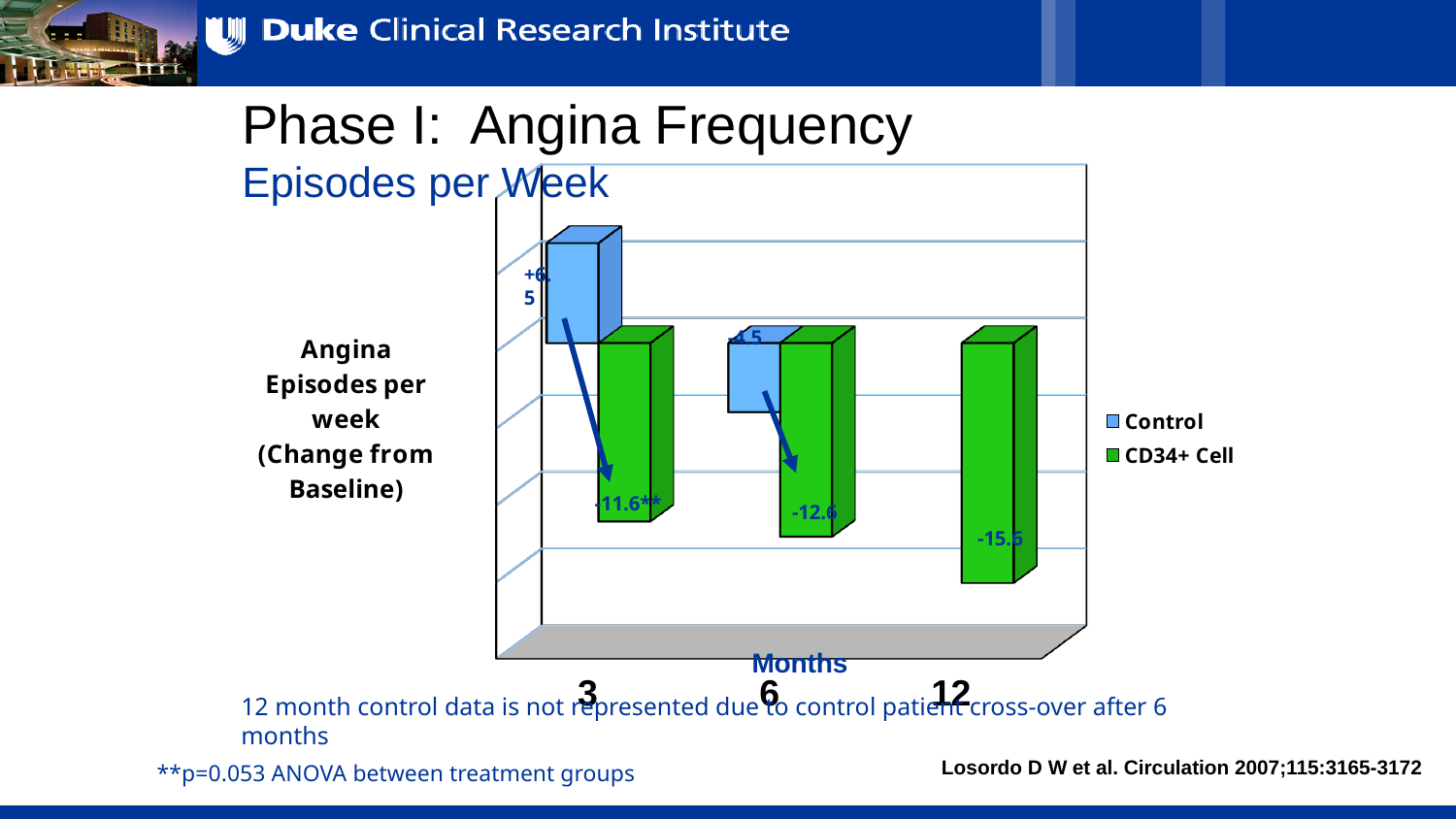
At 3 months, which series has the higher value, Control or CD34+ Cell? Control What is the value for the Control series at 3 months? +6.5 What is the difference between the CD34+ Cell values at 3 months and 12 months? 4.0 What is the value for the CD34+ Cell series at 3 months? -11.6 What is the value for the CD34+ Cell series at 12 months? -15.6 How many month categories are shown on the x axis? 3 What kind of chart is shown on the slide? bar chart What are the two series named in the legend? Control and CD34+ Cell What is the value for the CD34+ Cell series at 6 months? -12.6 Do the CD34+ Cell values rise or fall from 3 months to 12 months? fall At which month is the CD34+ Cell value lowest? 12 How many series does the legend list? 2